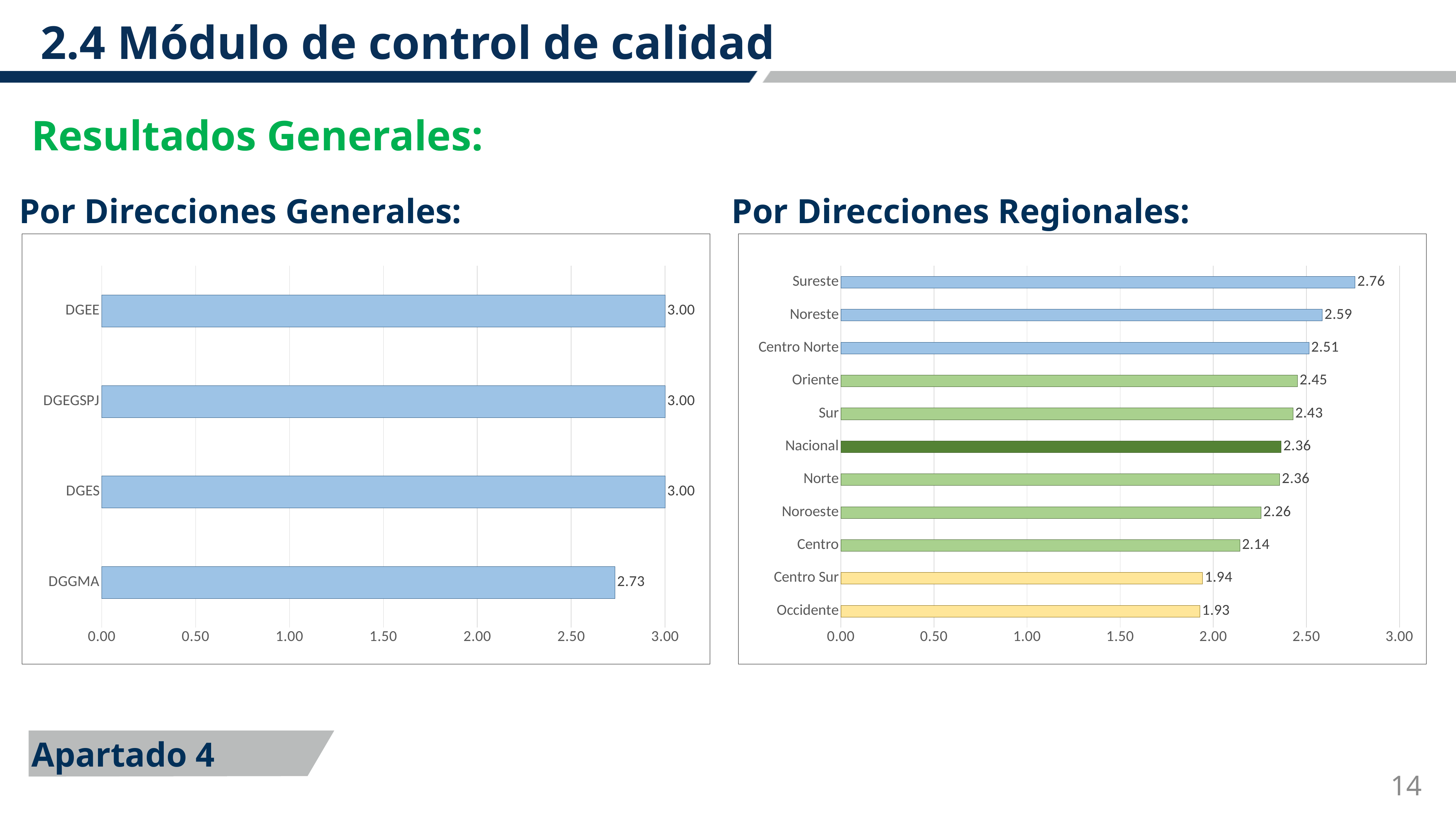
In the 'Por Direcciones Generales' chart, how many categories are shown? 4 In the 'Por Direcciones Regionales' chart, which is larger, the value for Noreste or the value for Centro? Noreste In the 'Por Direcciones Regionales' chart, how many categories are shown? 11 In the 'Por Direcciones Regionales' chart, which category has the highest value? Sureste In the 'Por Direcciones Regionales' chart, which category has the lowest value? Occidente In the 'Por Direcciones Generales' chart, which category has the lowest value? DGGMA In the 'Por Direcciones Generales' chart, what is the value for DGGMA? 2.73 What kind of chart is the 'Por Direcciones Regionales' chart? Bar chart In the 'Por Direcciones Generales' chart, what is the difference between the values for DGEE and DGGMA? 0.27 In the 'Por Direcciones Regionales' chart, what is the value for Sureste? 2.76 In the 'Por Direcciones Regionales' chart, what is the value for Nacional? 2.36 In the 'Por Direcciones Regionales' chart, what is the difference between the values for Sureste and Occidente? 0.83